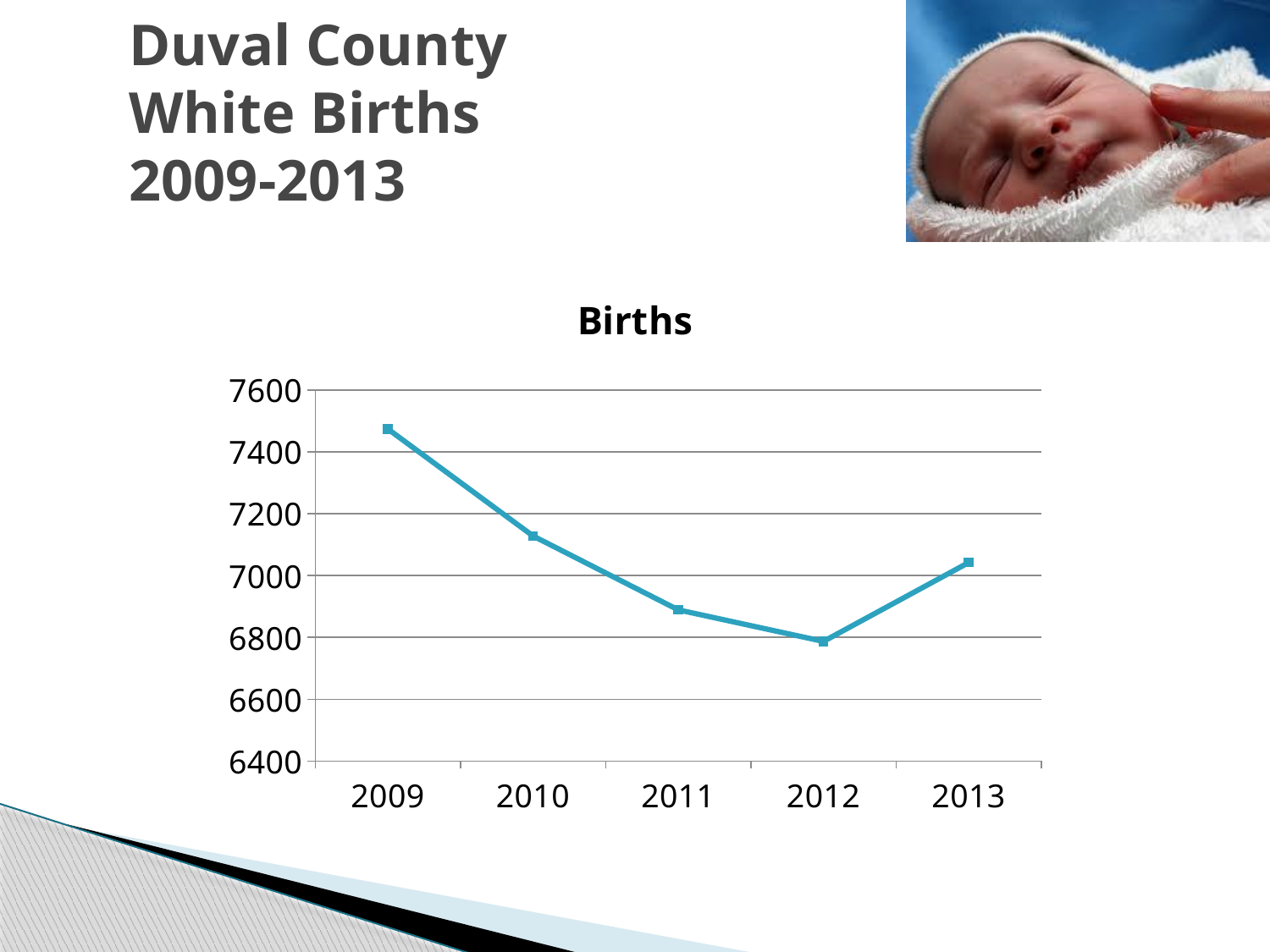
How do births change from 2009 to 2012? They fall Is the value for 2012 greater or less than 7000? less What kind of chart is shown on the slide? Line chart Which year has more births, 2009 or 2013? 2009 Is the value for 2011 greater or less than 7000? less Which year has the lowest number of births? 2012 Is the value for 2010 greater or less than 7200? less Which year has the highest number of births? 2009 How many years are plotted on the x axis of the chart? 5 What is the title of the chart? Births Which year has more births, 2010 or 2011? 2010